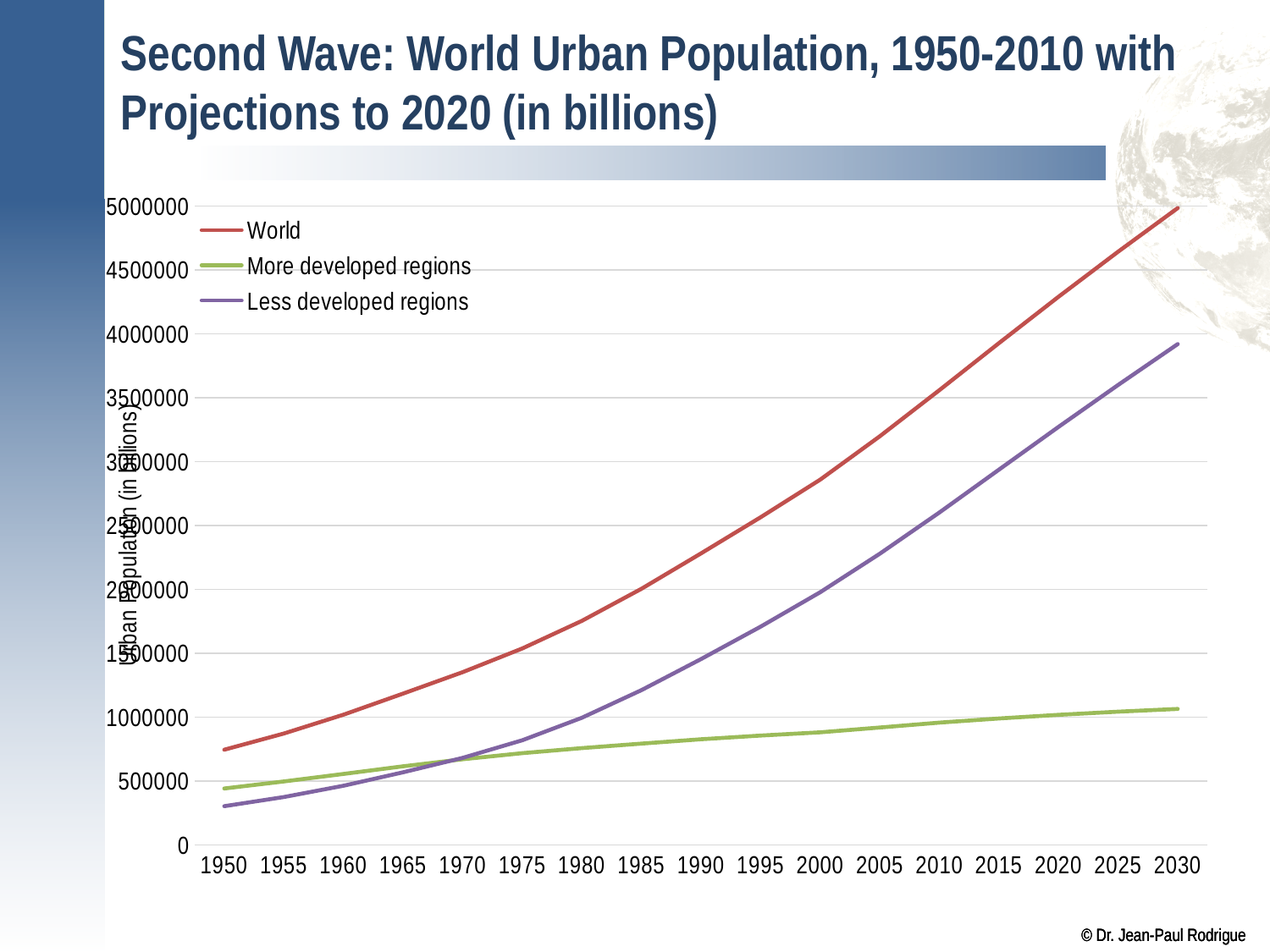
In 2030, which is larger: Less developed regions or More developed regions? Less developed regions How many series does the legend list? 3 How many years are marked along the x axis? 17 What colour is the line for the World series? red Which series has the highest value in 2030? World Which series has the lowest value in 1950? Less developed regions Does the World series rise or fall from 1950 to 2030? rise Which series has the lowest value in 2030? More developed regions In 1950, which is larger: More developed regions or Less developed regions? More developed regions Is the value for World in 2000 greater or less than 2500000? greater Is the value for Less developed regions in 1950 greater or less than 500000? less What kind of chart is shown on the slide? line chart